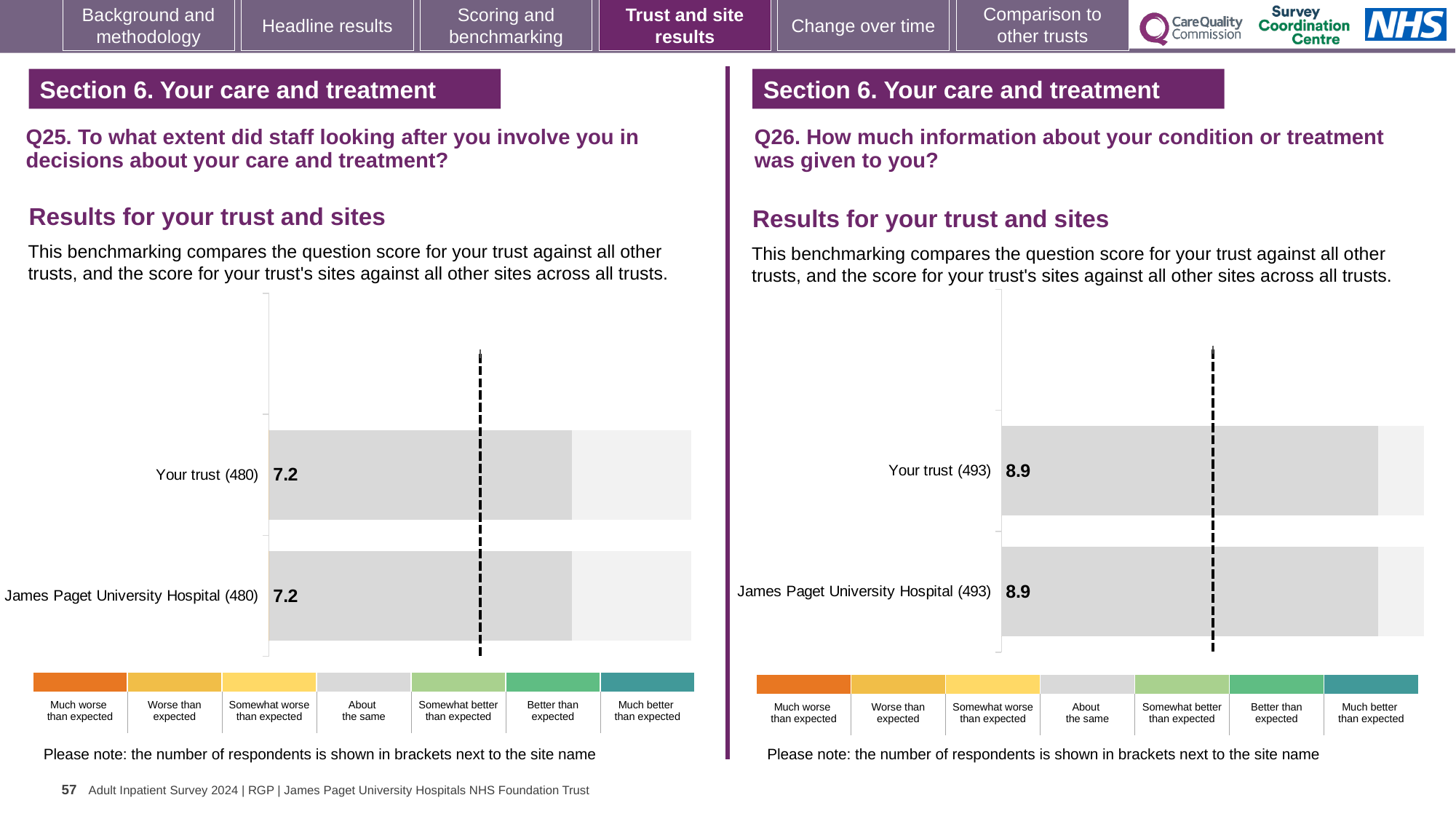
On the Q25 chart (left), how many respondents are shown in brackets for Your trust? 480 On the Q26 chart (right), what is the score for Your trust? 8.9 On the Q25 chart (left), what is the difference between the score for Your trust and the score for James Paget University Hospital? 0.0 On the Q25 chart (left), how many bars are plotted? 2 On the Q25 chart (left), what is the score for James Paget University Hospital? 7.2 On the Q26 chart (right), what is the difference between the score for Your trust and the score for James Paget University Hospital? 0.0 What kind of chart is the Q25 chart (left)? Bar chart On the Q26 chart (right), which benchmark category does the grey colour of the bars correspond to in the legend? About the same On the Q26 chart (right), what is the score for James Paget University Hospital? 8.9 On the Q25 chart (left), what is the score for Your trust? 7.2 On the Q26 chart (right), how many bars are plotted? 2 On the Q26 chart (right), how many respondents are shown in brackets for James Paget University Hospital? 493